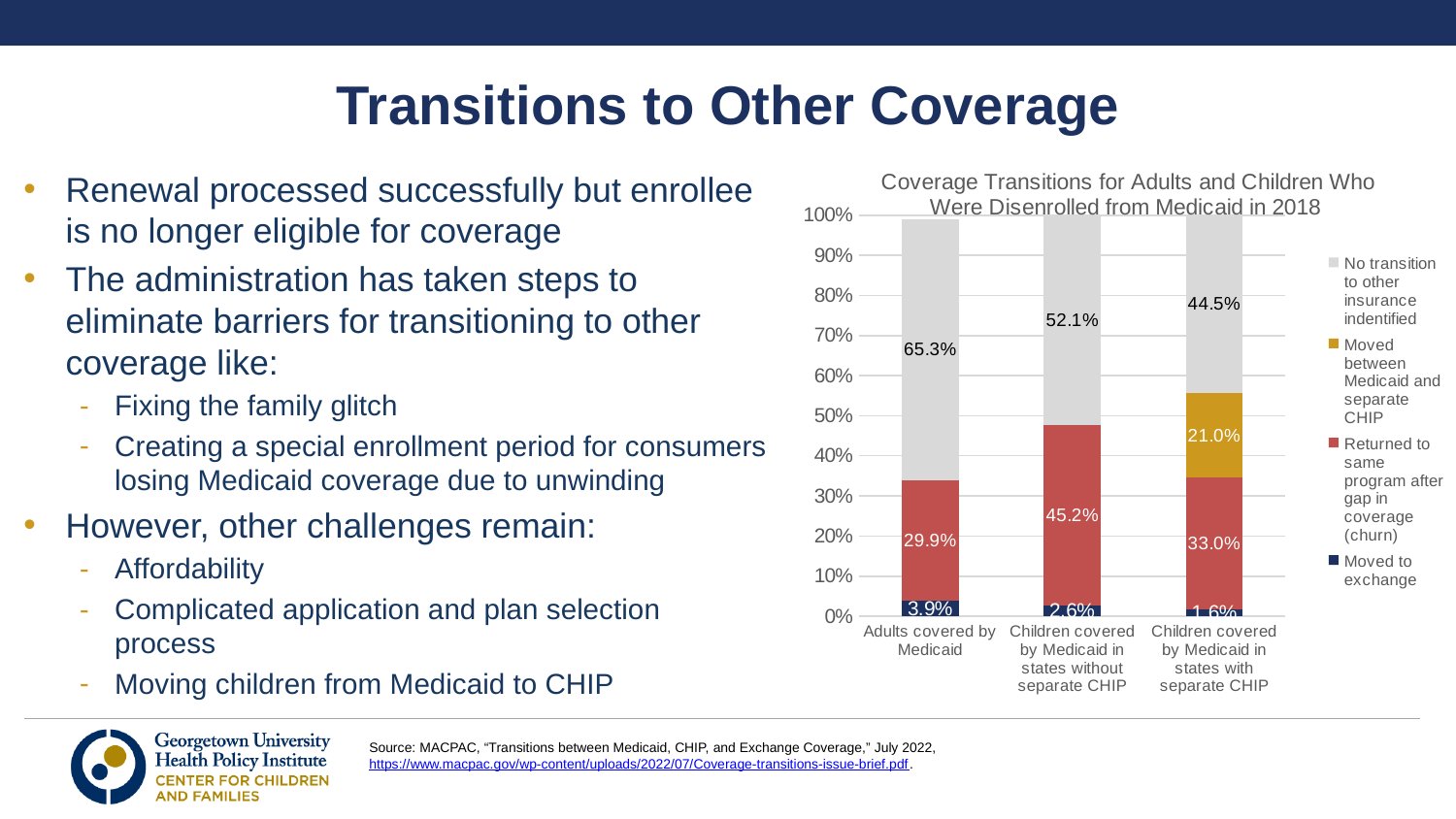
How much higher is the churn value for children covered by Medicaid in states without separate CHIP than for adults covered by Medicaid? 15.3 percentage points What is the title of the chart? Coverage Transitions for Adults and Children Who Were Disenrolled from Medicaid in 2018 Which has a larger 'No transition to other insurance identified' value: children in states without separate CHIP or children in states with separate CHIP? Children covered by Medicaid in states without separate CHIP Which category has the lowest 'Moved to exchange' value? Children covered by Medicaid in states with separate CHIP What type of chart is shown on the slide? Stacked bar chart How many categories are shown on the x axis of the chart? 3 What share of children covered by Medicaid in states with separate CHIP moved between Medicaid and separate CHIP? 21.0% What percentage of adults covered by Medicaid moved to the exchange? 3.9% What is the 'No transition to other insurance identified' value for adults covered by Medicaid? 65.3% How many series does the chart legend list? 4 What is the value for 'Returned to same program after gap in coverage (churn)' for children covered by Medicaid in states without separate CHIP? 45.2% Which category has the highest 'No transition to other insurance identified' value? Adults covered by Medicaid